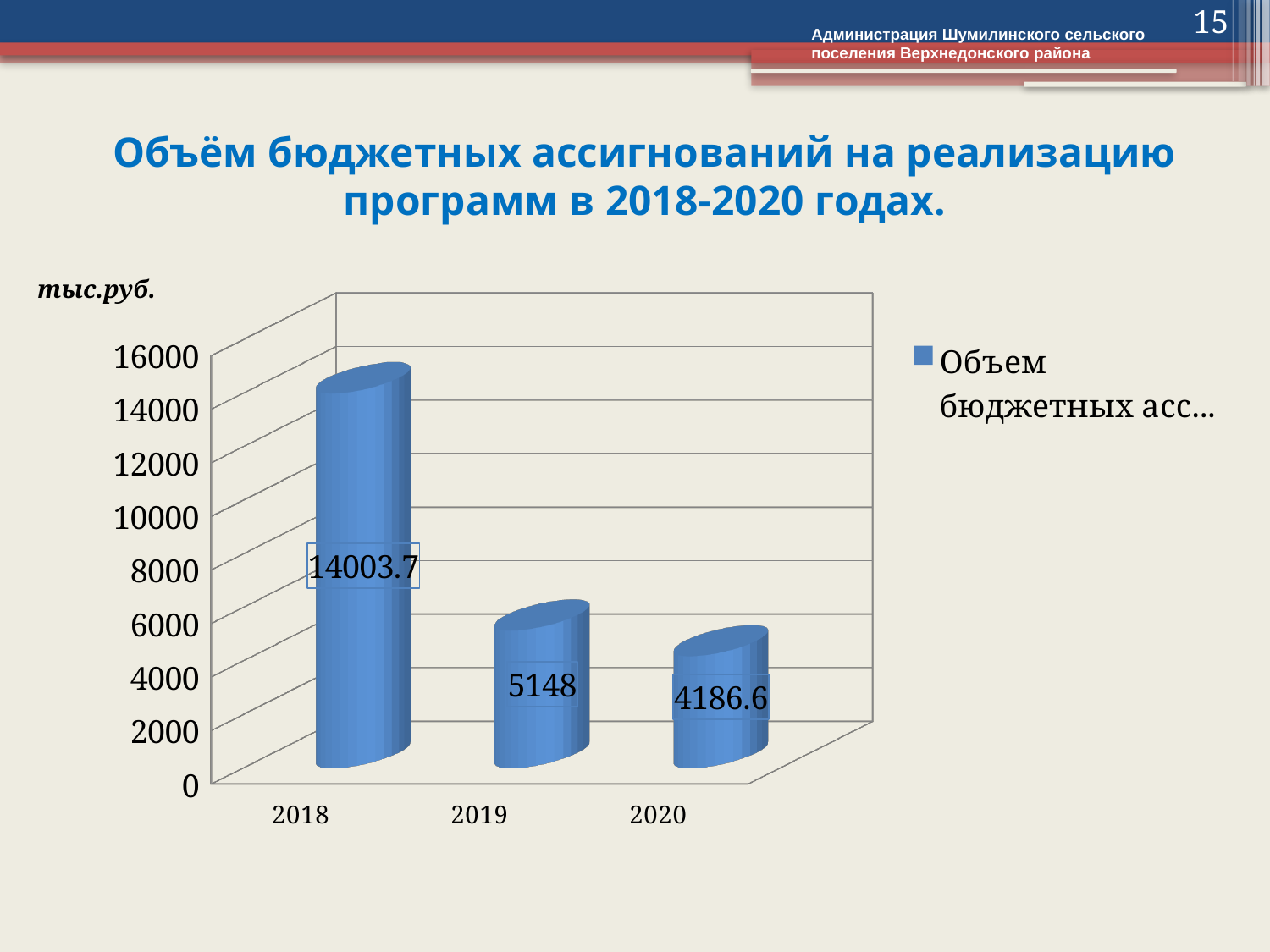
What unit is shown above the vertical axis? тыс.руб. What kind of chart is shown on the slide? bar chart Which is larger, the value for 2019 or the value for 2020? 2019 Which year has the lowest value? 2020 What is the difference between the values for 2019 and 2020? 961.4 What is the value for 2018? 14003.7 Which year has the highest value? 2018 What is the value for 2019? 5148 What is the value for 2020? 4186.6 What is the difference between the values for 2018 and 2019? 8855.7 Do the values rise or fall from 2018 to 2020? fall How many years are shown on the x axis? 3